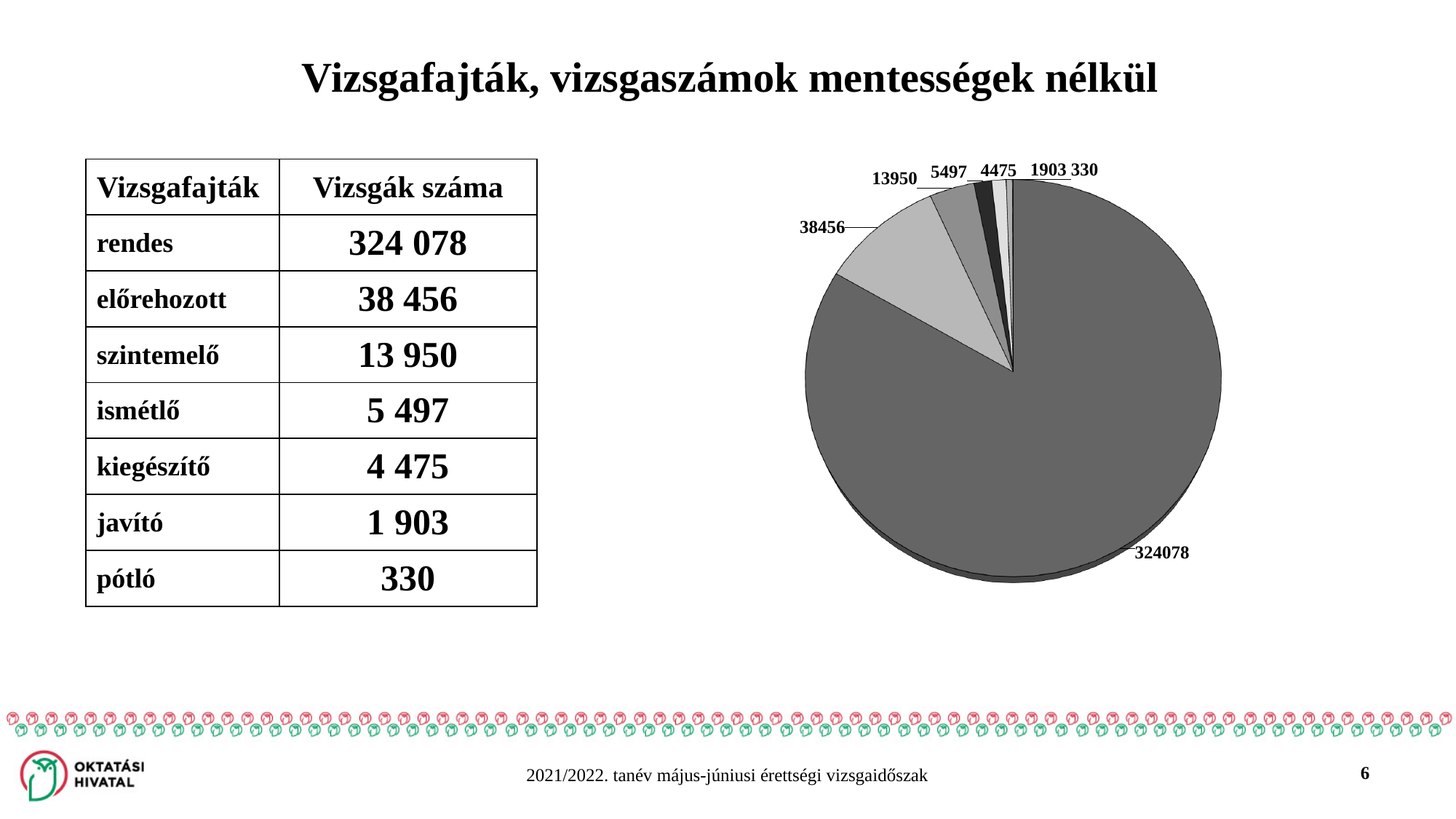
What is the value of the second-largest slice in the pie chart? 38456 What is the value of the smallest slice in the pie chart? 330 What kind of chart is shown on the slide? pie chart What is the value of the largest slice in the pie chart? 324078 What is the title of the slide containing the pie chart? Vizsgafajták, vizsgaszámok mentességek nélkül What is the difference between the largest slice (324078) and the second-largest slice (38456) in the pie chart? 285622 According to the table on the slide, which exam type (vizsgafajta) does the largest slice of the pie chart represent? rendes What is the difference between the slices labelled 38456 and 13950 in the pie chart? 24506 What is the total of all slice values shown in the pie chart? 388689 Which slice is larger in the pie chart, the one labelled 5497 or the one labelled 4475? 5497 How many slices does the pie chart have? 7 Does the pie chart have a legend? No